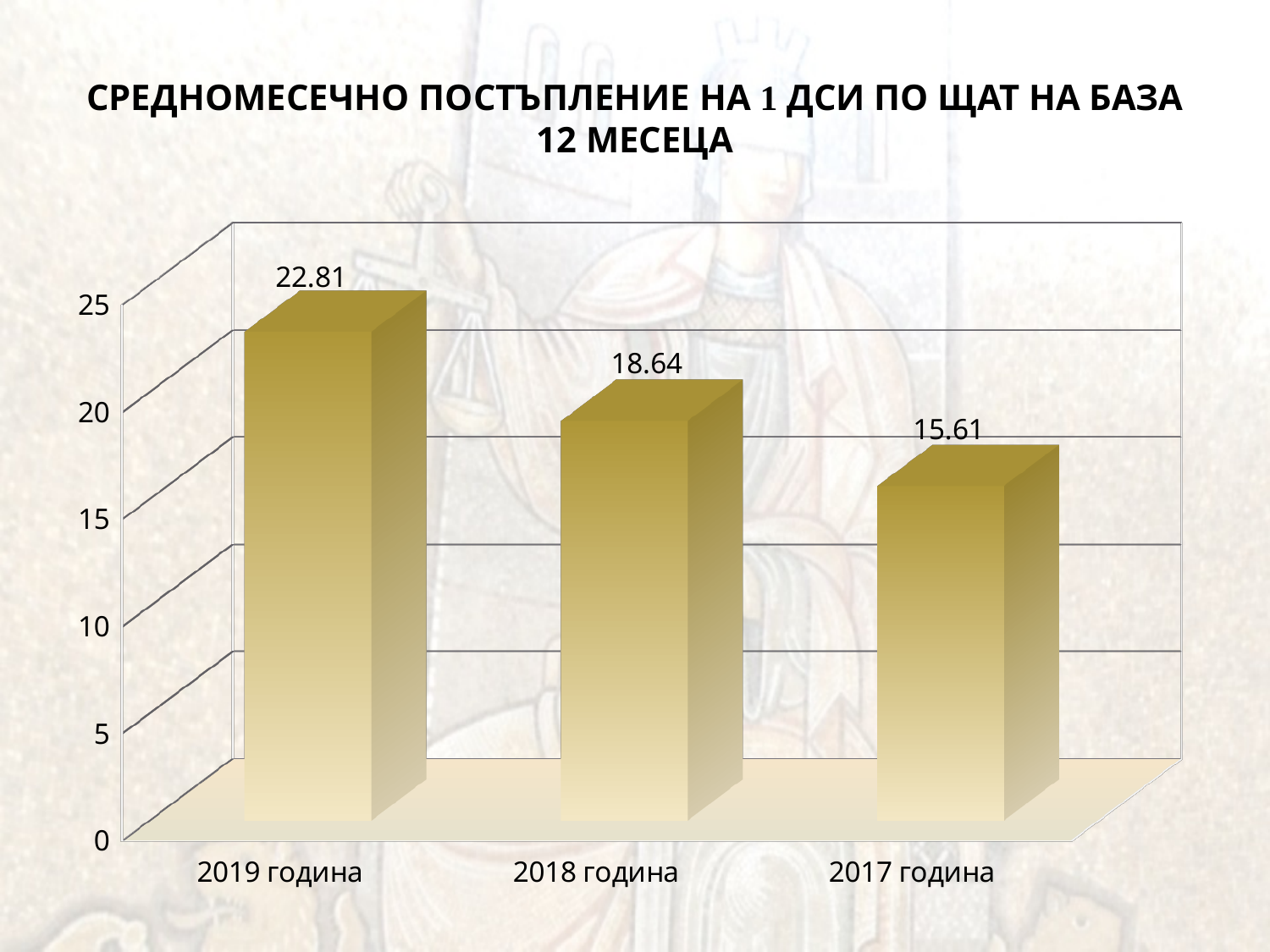
Which year has the highest value? 2019 година What is the value for 2018 година? 18.64 What is the value for 2019 година? 22.81 What is the difference between the values for 2019 година and 2017 година? 7.20 Is the value for 2018 година greater or less than 20? less How many categories are shown on the x axis? 3 Do the values rise or fall from left to right along the x axis? fall What is the value for 2017 година? 15.61 Which year has the lowest value? 2017 година Which is larger, the value for 2018 година or the value for 2017 година? 2018 година What is the difference between the values for 2019 година and 2018 година? 4.17 What kind of chart is shown on the slide? bar chart